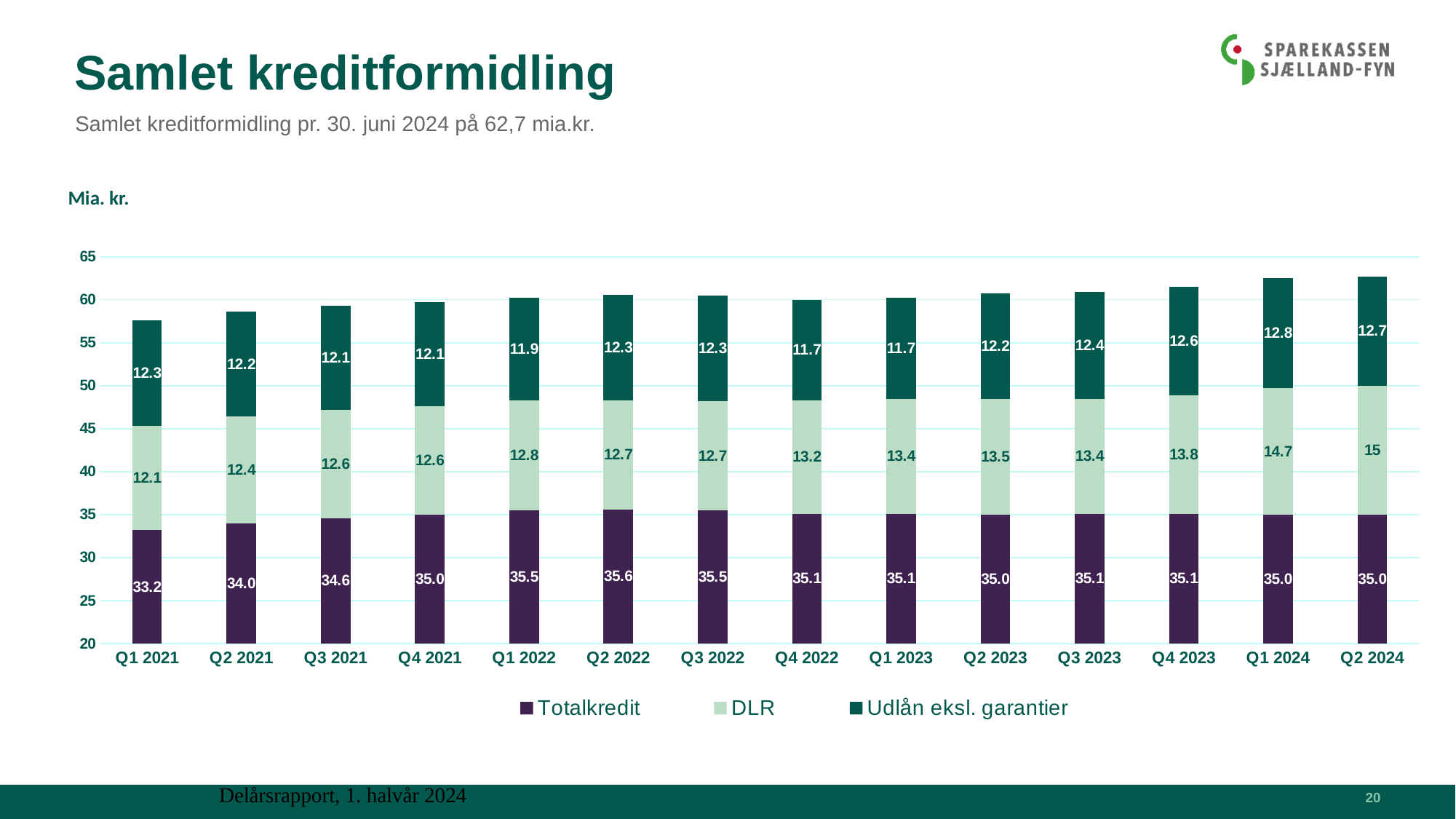
Does the DLR value rise or fall from Q1 2021 to Q2 2024? Rise How many quarters are shown on the x axis? 14 How many series does the legend list? 3 Which is larger, the Udlån eksl. garantier value for Q1 2022 or for Q2 2022? Q2 2022 What is the total of the stacked bar for Q2 2024? 62.7 What is the Totalkredit value for Q1 2021? 33.2 What is the DLR value for Q2 2024? 15 In which quarter is the Totalkredit value lowest? Q1 2021 What is the difference between the DLR value in Q2 2024 and in Q1 2021? 2.9 What is the Udlån eksl. garantier value for Q1 2024? 12.8 What kind of chart is shown on the slide? Stacked bar chart In which quarter is the DLR value highest? Q2 2024